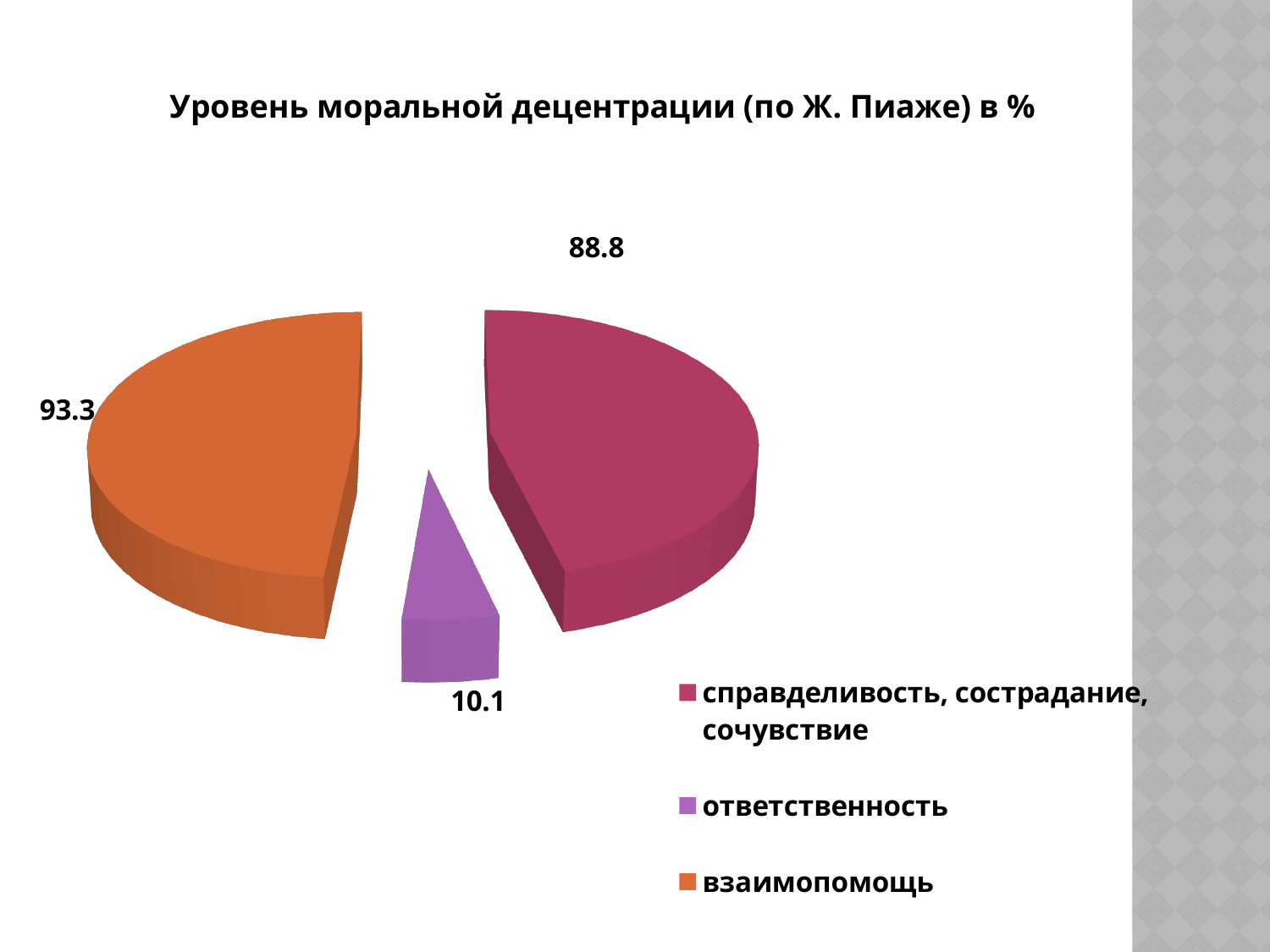
What is the value for справедливость, сострадание, сочувствие? 88.8 What colour is the slice for взаимопомощь? Orange Which category has the highest value? взаимопомощь What is the value for взаимопомощь? 93.3 What is the value for ответственность? 10.1 Which is larger: the value for справедливость, сострадание, сочувствие or the value for ответственность? справедливость, сострадание, сочувствие How many slices does the pie chart have? 3 What is the difference between the values for взаимопомощь and справедливость, сострадание, сочувствие? 4.5 What is the title of the chart? Уровень моральной децентрации (по Ж. Пиаже) в % What is the difference between the values for взаимопомощь and ответственность? 83.2 What type of chart is shown on the slide? Pie chart Which category has the lowest value? ответственность